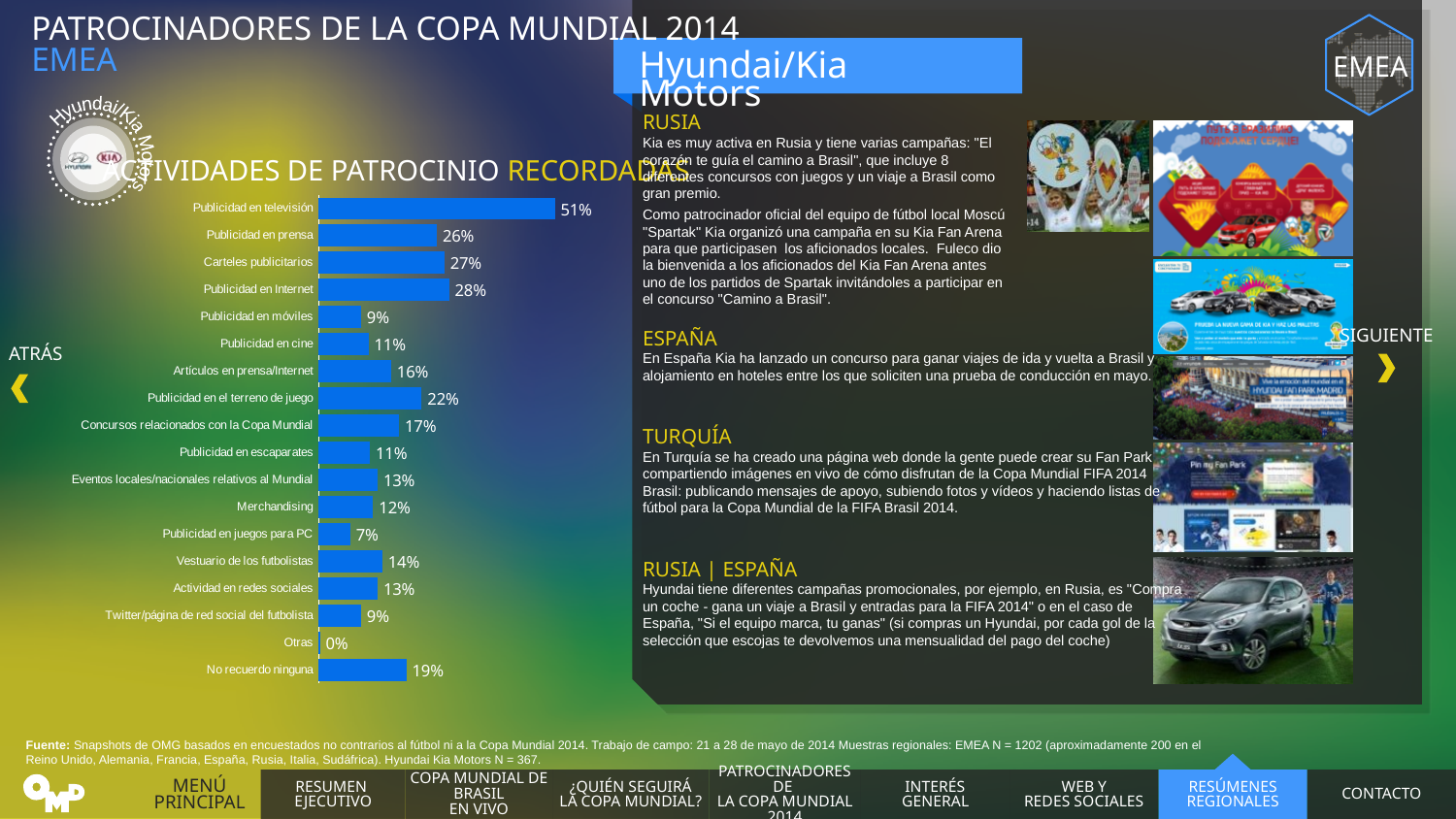
What is the value for Publicidad en Internet? 28% What type of chart is used to show the sponsorship activities recalled? Bar chart How many categories are shown in the bar chart? 18 What is the value for No recuerdo ninguna? 19% What is the title of the bar chart? ACTIVIDADES DE PATROCINIO RECORDADAS What is the difference between Publicidad en televisión and Publicidad en Internet? 23% What is the value for Publicidad en juegos para PC? 7% Which is larger, Carteles publicitarios or Publicidad en prensa? Carteles publicitarios What is the value for Publicidad en televisión? 51% Which category has the highest value in the chart? Publicidad en televisión Which category has the lowest value in the chart? Otras What is the difference between Publicidad en el terreno de juego and Concursos relacionados con la Copa Mundial? 5%